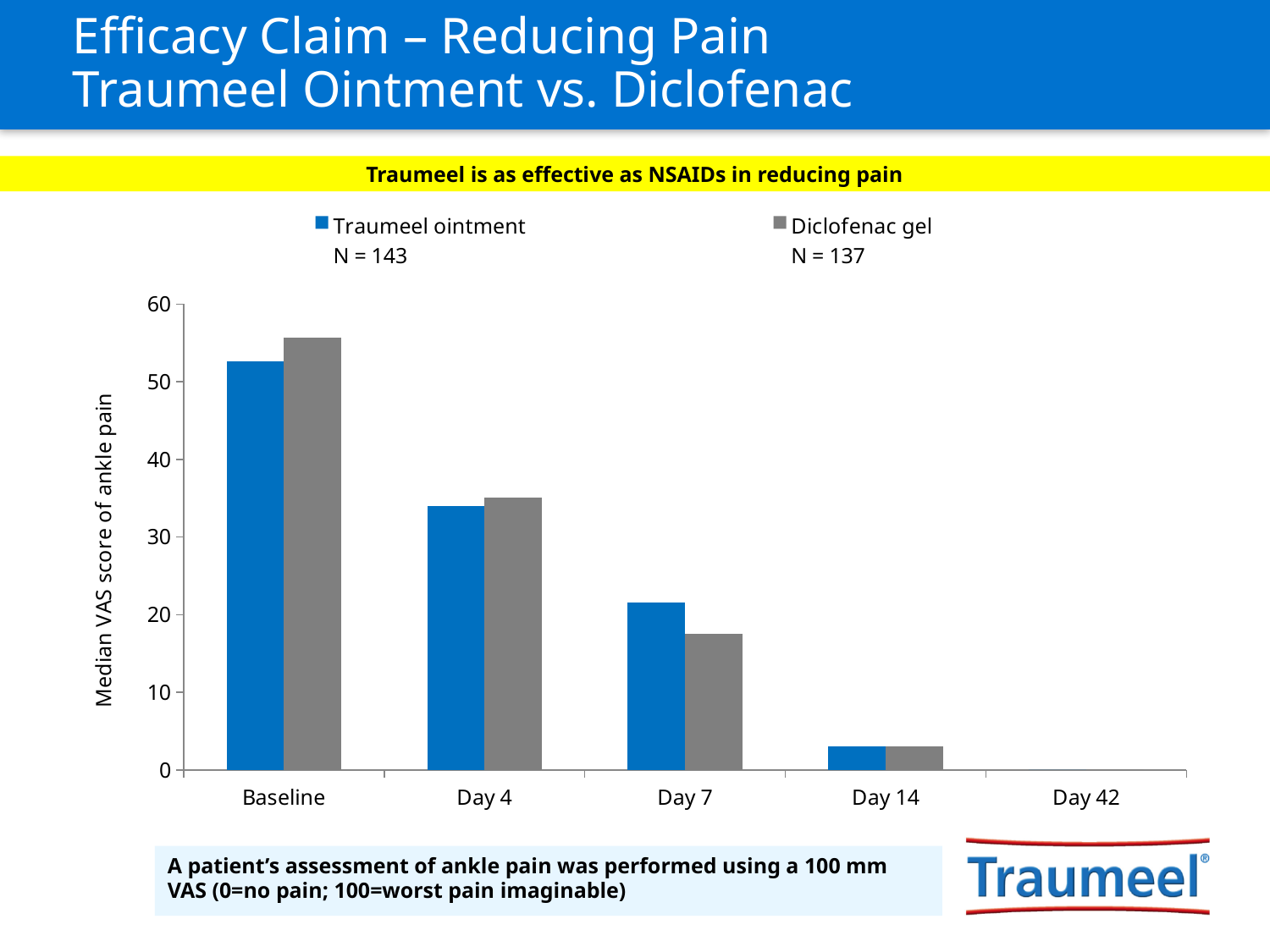
Is the Baseline value for Traumeel ointment greater or less than 50? greater At Baseline, which series has the larger median VAS score, Traumeel ointment or Diclofenac gel? Diclofenac gel Do the Traumeel ointment values rise or fall from Baseline to Day 42? fall What kind of chart is shown on the slide? Bar chart What is the N shown in the legend for Diclofenac gel? N = 137 Is the Day 14 value for Traumeel ointment greater or less than 10? less Is the Day 4 value for Diclofenac gel greater or less than 40? less At which time point is the Traumeel ointment median VAS score highest? Baseline What is the label of the y axis? Median VAS score of ankle pain How many time-point categories are shown on the x axis? 5 How many series does the legend list? 2 At Day 7, which series has the larger median VAS score, Traumeel ointment or Diclofenac gel? Traumeel ointment